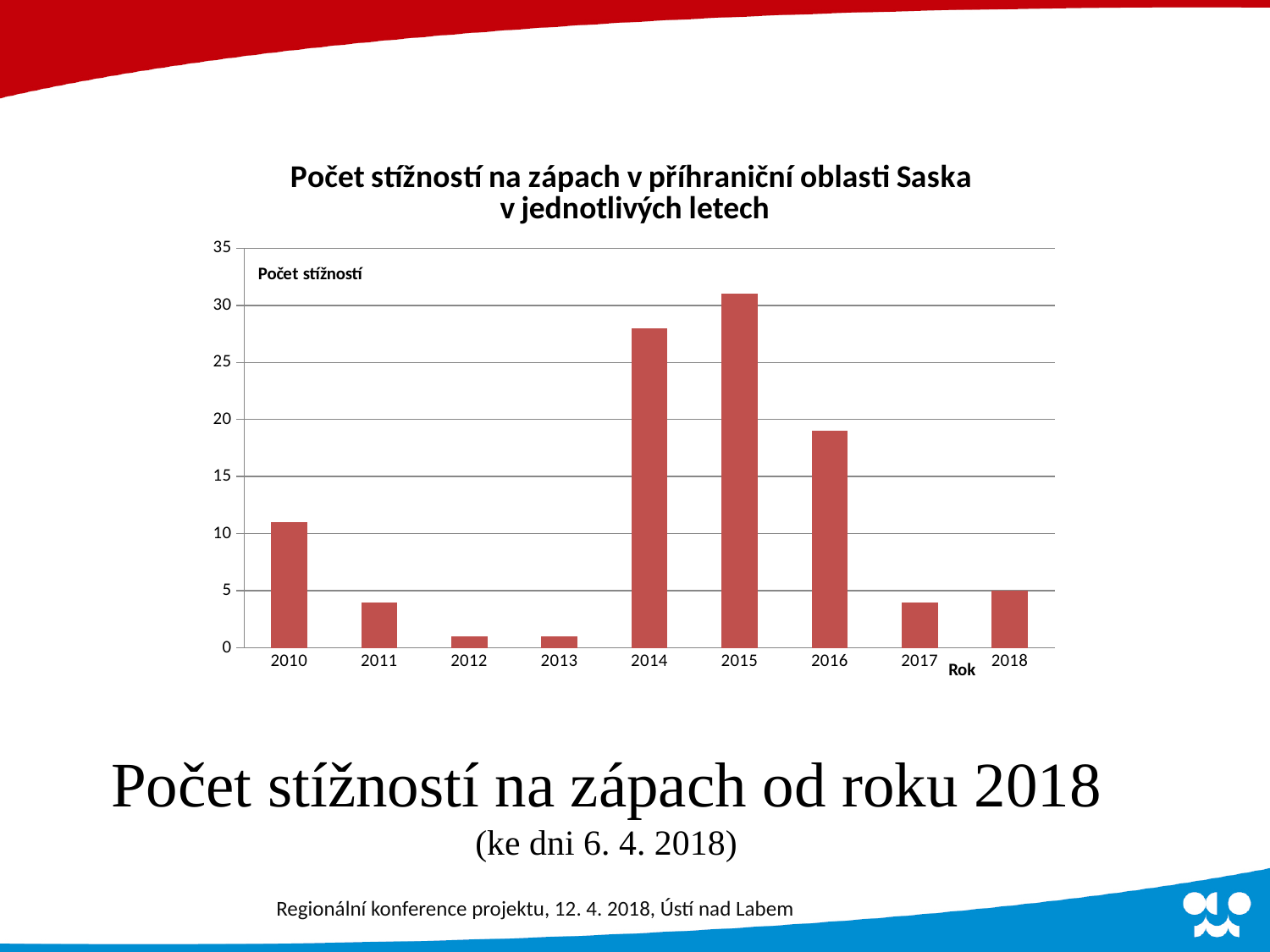
What is the label on the x axis of the chart? Rok Is the value for 2015 greater or less than 25? greater Which year has the highest number of complaints in the chart? 2015 Which year has more complaints, 2010 or 2011? 2010 Which year has more complaints, 2014 or 2016? 2014 Is the value for 2016 greater or less than 15? greater What is the label on the y axis of the chart? Počet stížností Is the value for 2014 greater or less than 25? greater What kind of chart is shown on the slide? bar chart How many years are shown on the x axis of the chart? 9